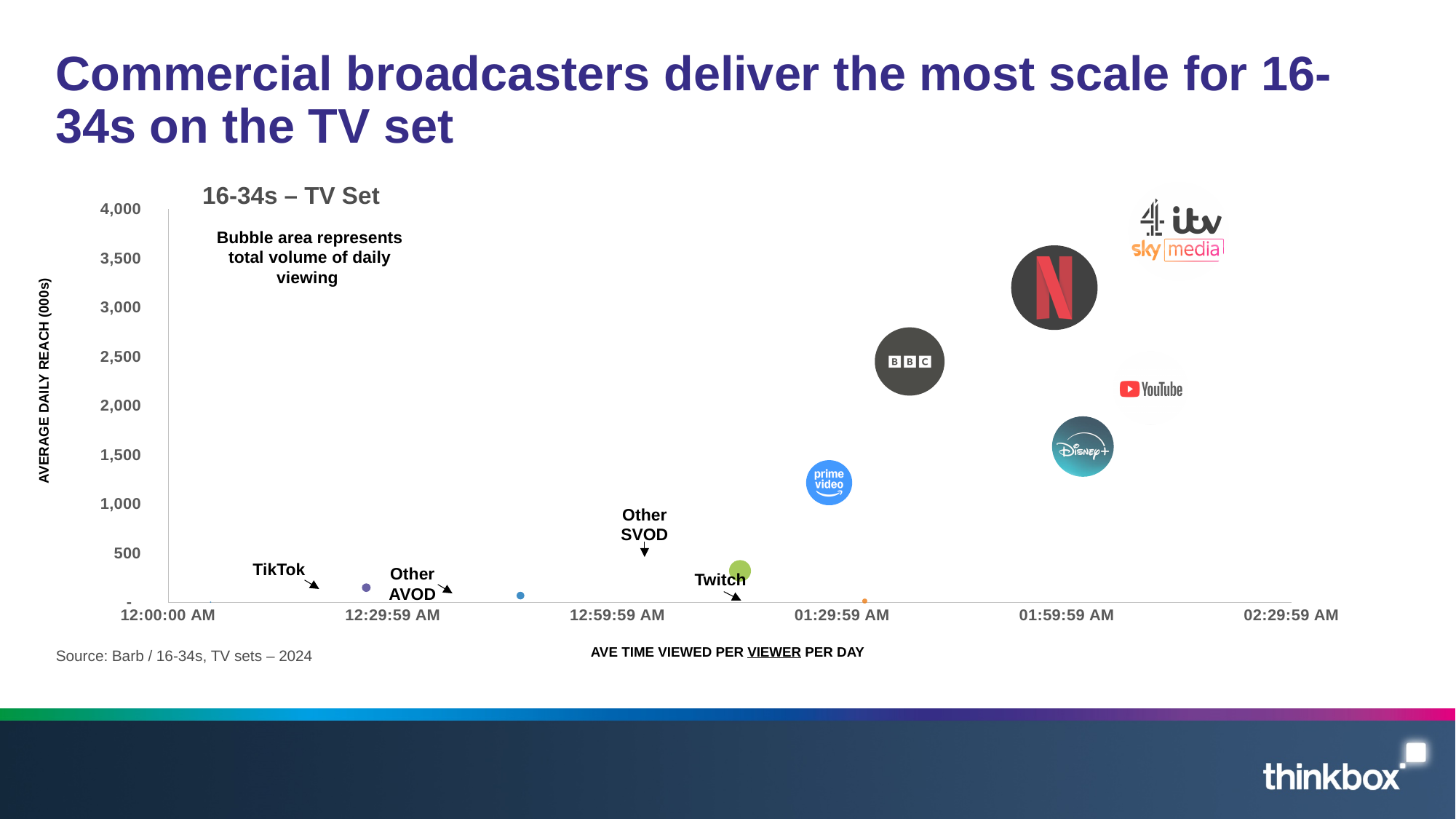
Is the average daily reach for YouTube greater or less than 2,500? less Is the average daily reach for BBC greater or less than 2,000? greater Does average daily reach generally rise or fall as average time viewed per viewer per day increases? Rise Is the average daily reach for Prime Video greater or less than 1,500? less Which has the higher average daily reach, Netflix or BBC? Netflix What kind of chart is shown on the slide? Bubble chart What is the title of the chart? 16-34s – TV Set What does the bubble area represent in the chart? Total volume of daily viewing Which platform has the lowest average daily reach on the chart? Twitch Which has the higher average daily reach, Disney+ or Prime Video? Disney+